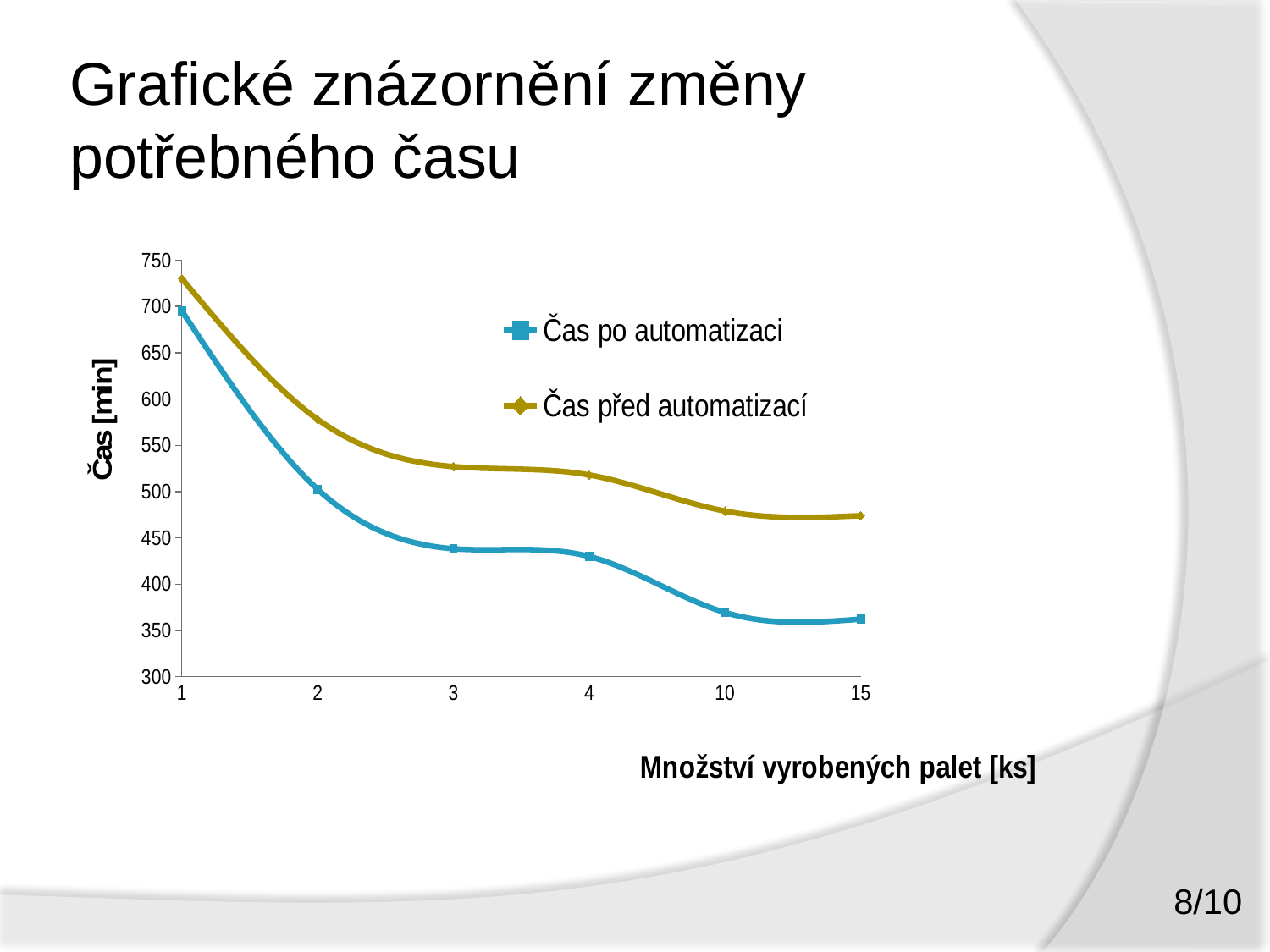
Is the value for Čas po automatizaci at x = 1 greater or less than 650? greater At which x-axis value is Čas po automatizaci highest? 1 Do the values for Čas po automatizaci rise or fall as the number of pallets increases along the x axis? fall At which x-axis value is Čas před automatizací highest? 1 Is the value for Čas před automatizací at x = 15 greater or less than 500? less How many series does the legend list? 2 Which series is shown in blue in the legend? Čas po automatizaci How many points are plotted along the x axis for each series? 6 What kind of chart is shown on the slide? line chart At x = 4, which series has the larger value, Čas po automatizaci or Čas před automatizací? Čas před automatizací Is the value for Čas po automatizaci at x = 10 greater or less than 400? less What is the label of the y axis? Čas [min]